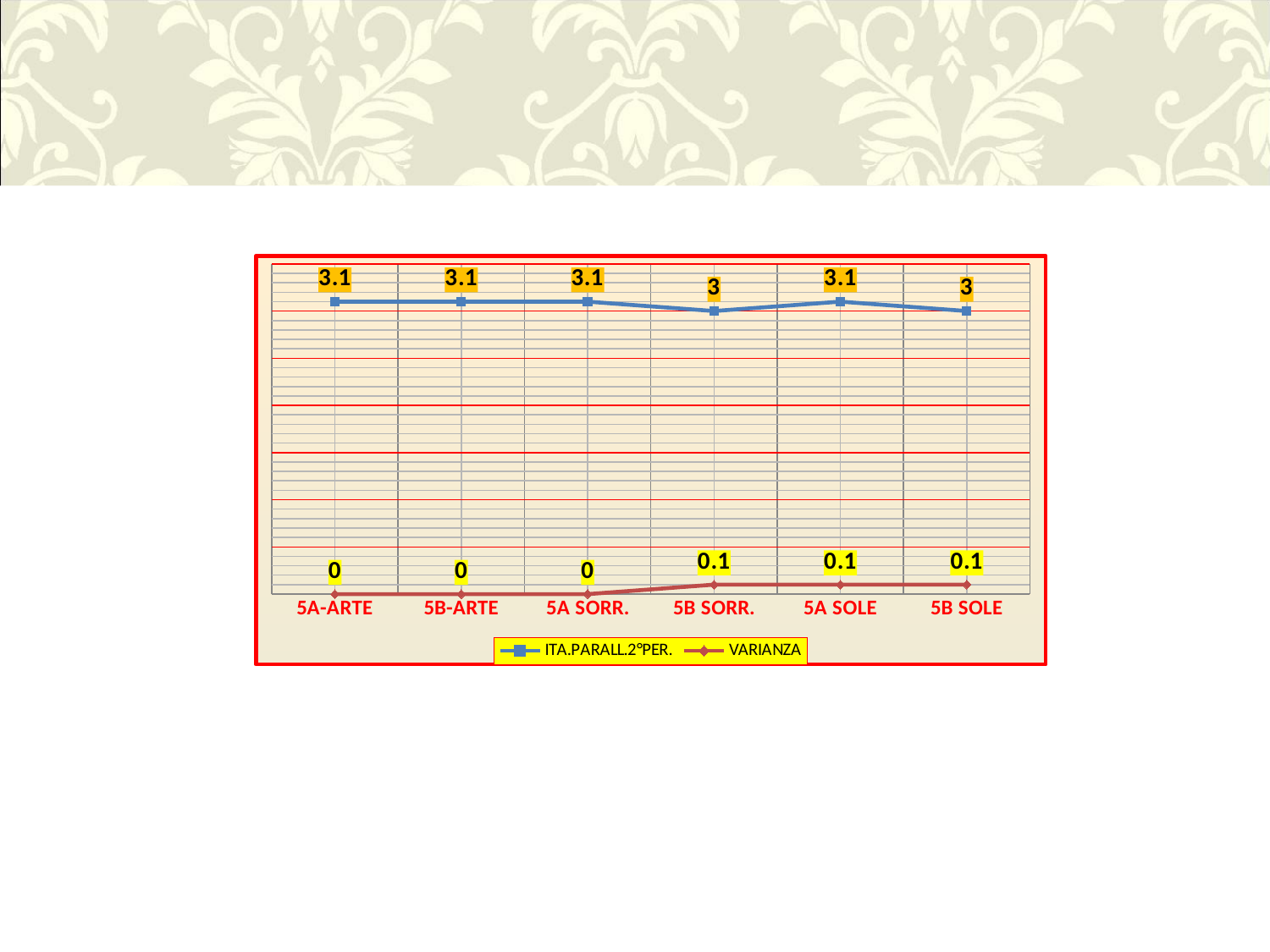
Which category has the lowest VARIANZA value among 5B SORR., 5A SOLE and 5B SOLE compared with 5A-ARTE? 5A-ARTE What is the VARIANZA value for 5A SOLE? 0.1 What is the ITA.PARALL.2°PER. value for 5B SOLE? 3 What is the ITA.PARALL.2°PER. value for 5B SORR.? 3 How many series does the legend list? 2 How many categories are shown on the x axis? 6 Which is larger, the ITA.PARALL.2°PER. value for 5A SORR. or for 5B SORR.? 5A SORR. What is the difference between the ITA.PARALL.2°PER. values for 5A SOLE and 5B SOLE? 0.1 What is the ITA.PARALL.2°PER. value for 5A-ARTE? 3.1 What are the two series names listed in the legend? ITA.PARALL.2°PER. and VARIANZA What kind of chart is shown on the slide? line chart What is the VARIANZA value for 5B-ARTE? 0